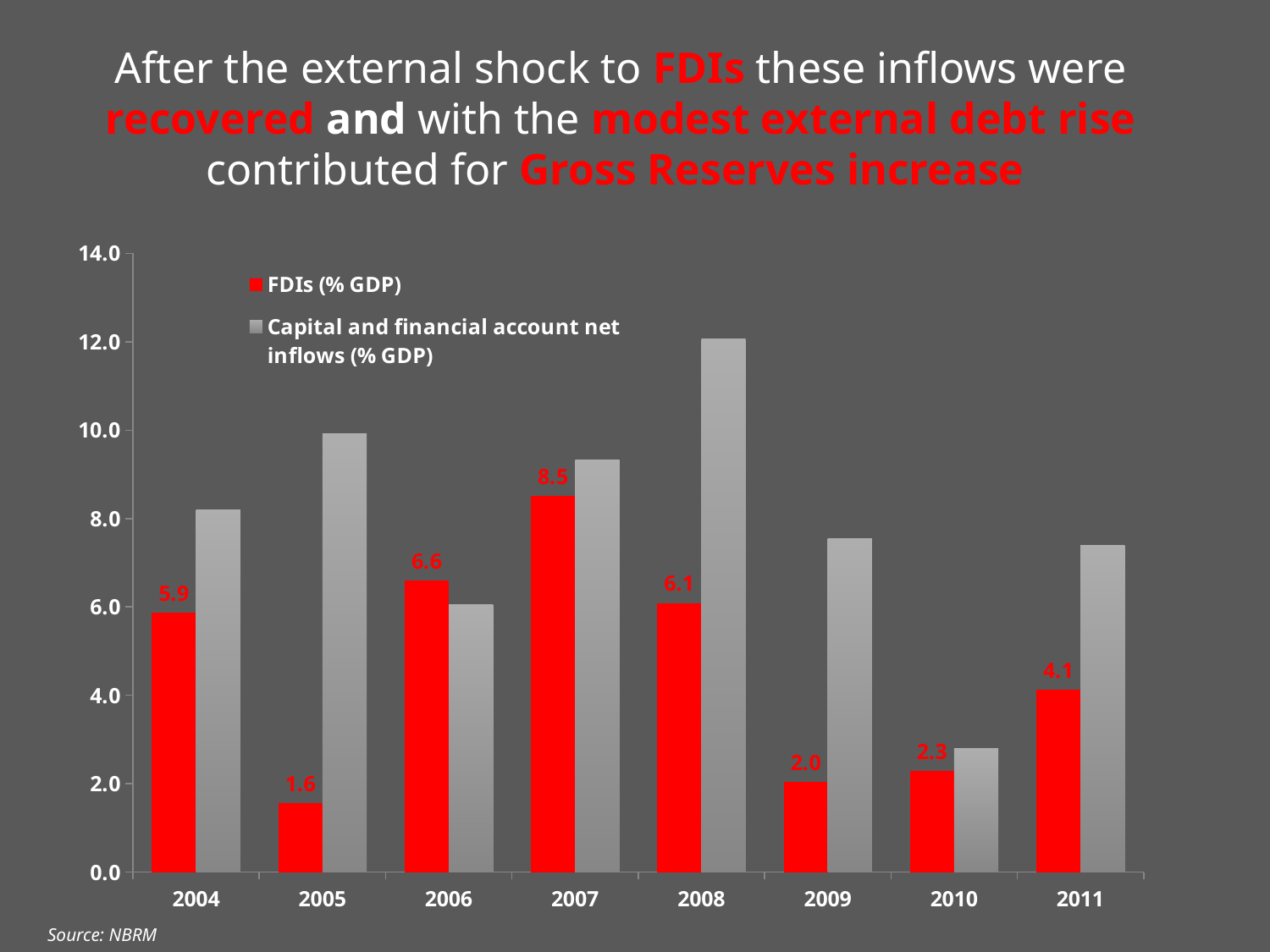
How many years are shown on the x axis of the chart? 8 What is the value of FDIs (% GDP) in 2007? 8.5 Which is larger, FDIs (% GDP) in 2004 or in 2008? 2008 In which year is FDIs (% GDP) lowest? 2005 What kind of chart is shown on the slide? Bar chart How many series does the legend list? 2 In which year is FDIs (% GDP) highest? 2007 What is the difference between FDIs (% GDP) in 2007 and in 2005? 6.9 Is the value for Capital and financial account net inflows (% GDP) in 2010 greater or less than 4.0? less What is the value of FDIs (% GDP) in 2005? 1.6 What is the value of FDIs (% GDP) in 2011? 4.1